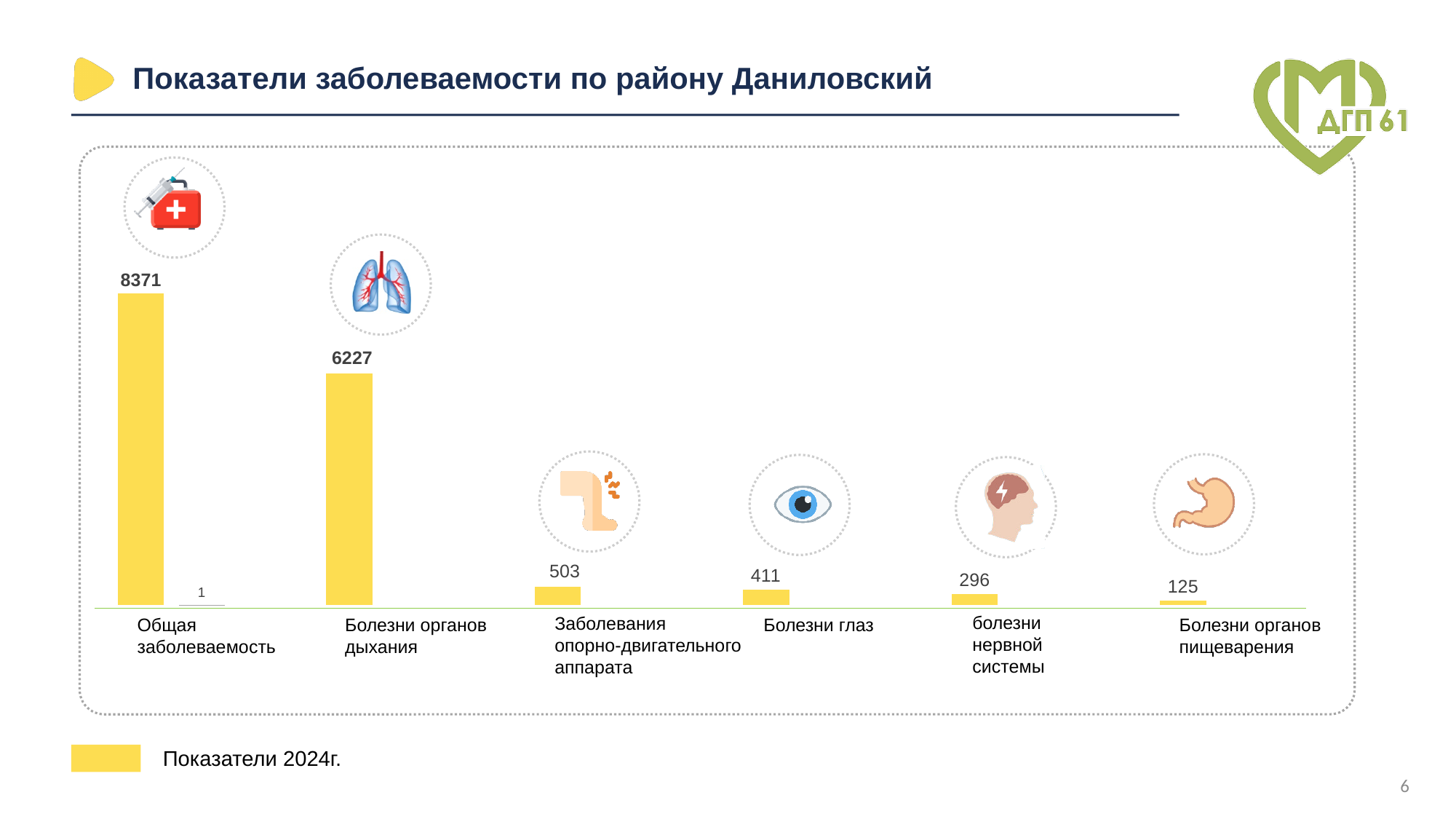
What kind of chart is shown on the slide? Bar chart What is the value shown for Болезни органов дыхания? 6227 What is the value shown for болезни нервной системы? 296 Which is larger, the value for Болезни глаз or the value for болезни нервной системы? Болезни глаз What is the value shown for Болезни глаз? 411 What is the value shown for Заболевания опорно-двигательного аппарата? 503 Which category has the lowest value? Болезни органов пищеварения What is the value shown for Общая заболеваемость? 8371 What is the difference between the values for Общая заболеваемость and Болезни органов дыхания? 2144 What is the value shown for Болезни органов пищеварения? 125 Which category has the highest value? Общая заболеваемость How many categories are shown on the x axis of the chart? 6